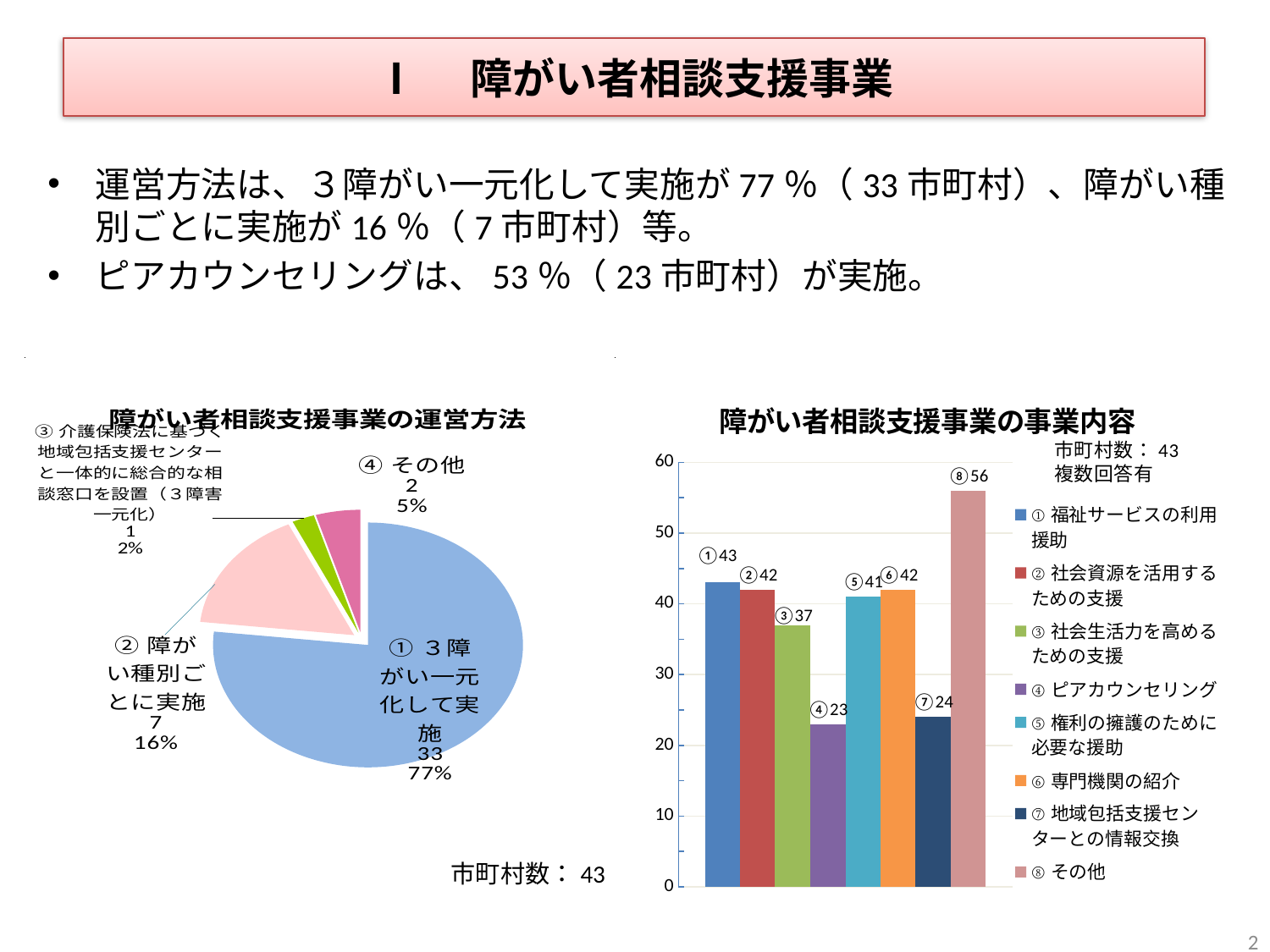
In the bar chart 障がい者相談支援事業の事業内容, which is larger: ③ 社会生活力を高めるための支援 or ⑦ 地域包括支援センターとの情報交換? ③ 社会生活力を高めるための支援 What type of chart is the chart on the right titled 障がい者相談支援事業の事業内容? bar chart In the bar chart 障がい者相談支援事業の事業内容, which category has the lowest value? ④ ピアカウンセリング In the pie chart 障がい者相談支援事業の運営方法, how many slices are there? 4 In the bar chart 障がい者相談支援事業の事業内容, what is the value for ④ ピアカウンセリング? 23 In the pie chart 障がい者相談支援事業の運営方法, how many municipalities are in the ② 障がい種別ごとに実施 slice? 7 In the bar chart 障がい者相談支援事業の事業内容, which category has the highest value? ⑧ その他 In the bar chart 障がい者相談支援事業の事業内容, what is the difference between ⑧ その他 and ① 福祉サービスの利用援助? 13 In the bar chart 障がい者相談支援事業の事業内容, how many entries does the legend list? 8 In the pie chart 障がい者相談支援事業の運営方法, what percentage share does ① ３障がい一元化して実施 have? 77% In the pie chart 障がい者相談支援事業の運営方法, what is the difference in municipalities between ① ３障がい一元化して実施 and ② 障がい種別ごとに実施? 26 In the pie chart 障がい者相談支援事業の運営方法, which category has the smallest slice? ③ 介護保険法に基づく地域包括支援センターと一体的に総合的な相談窓口を設置（３障害一元化）